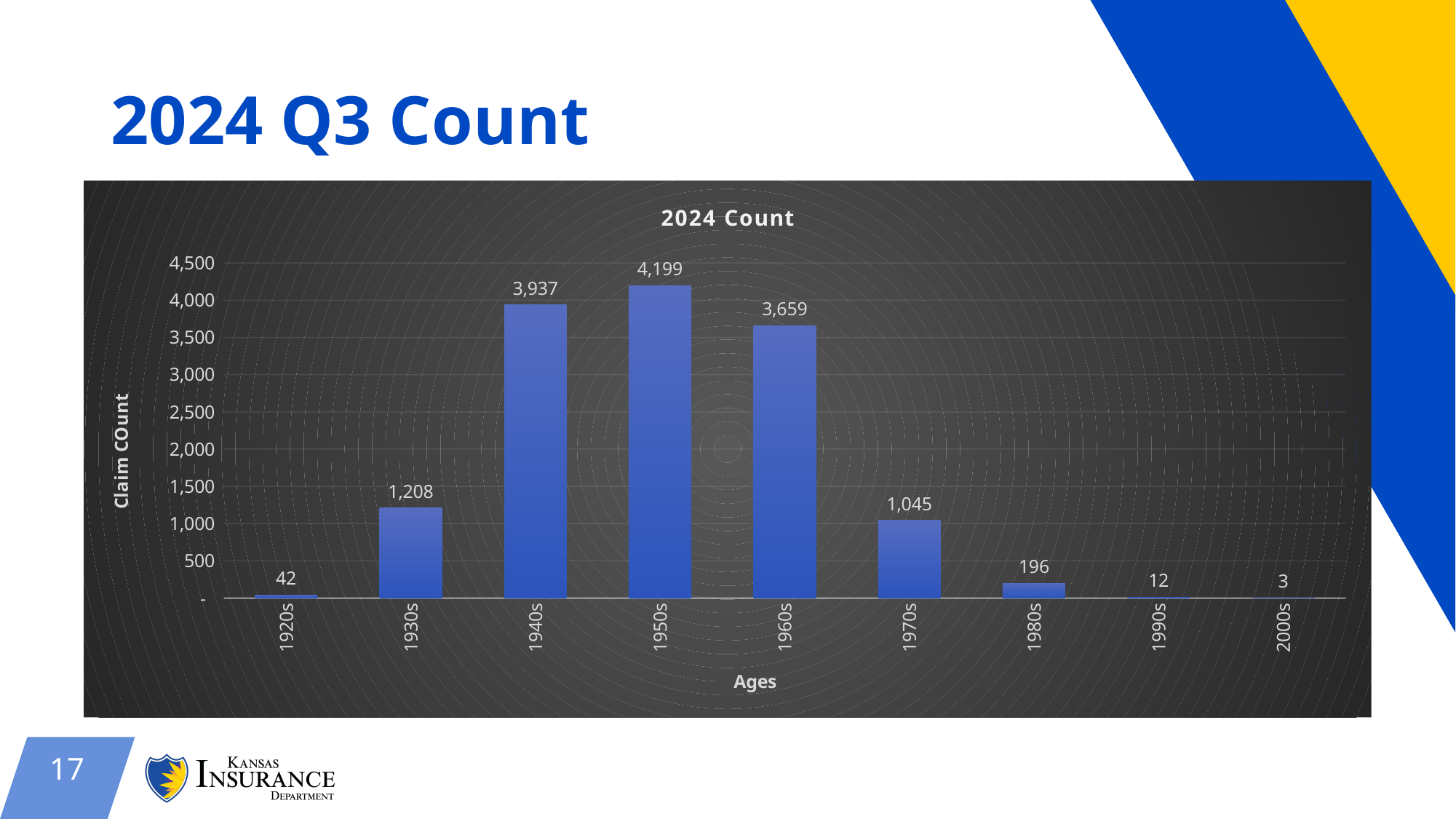
What is the claim count for the 1930s age group? 1,208 What is the claim count for the 1950s age group? 4,199 Which age group has the highest claim count? 1950s What is the label of the vertical axis? Claim Count What is the title of the chart? 2024 Count Which age group has the lowest claim count? 2000s What is the difference between the claim counts for the 1940s and the 1960s? 278 How many age groups are shown on the x axis? 9 Which age group has a larger claim count, the 1970s or the 1930s? 1930s Is the value for the 1960s greater or less than 3,500? greater What kind of chart is shown on the slide? bar chart What is the claim count for the 1980s age group? 196